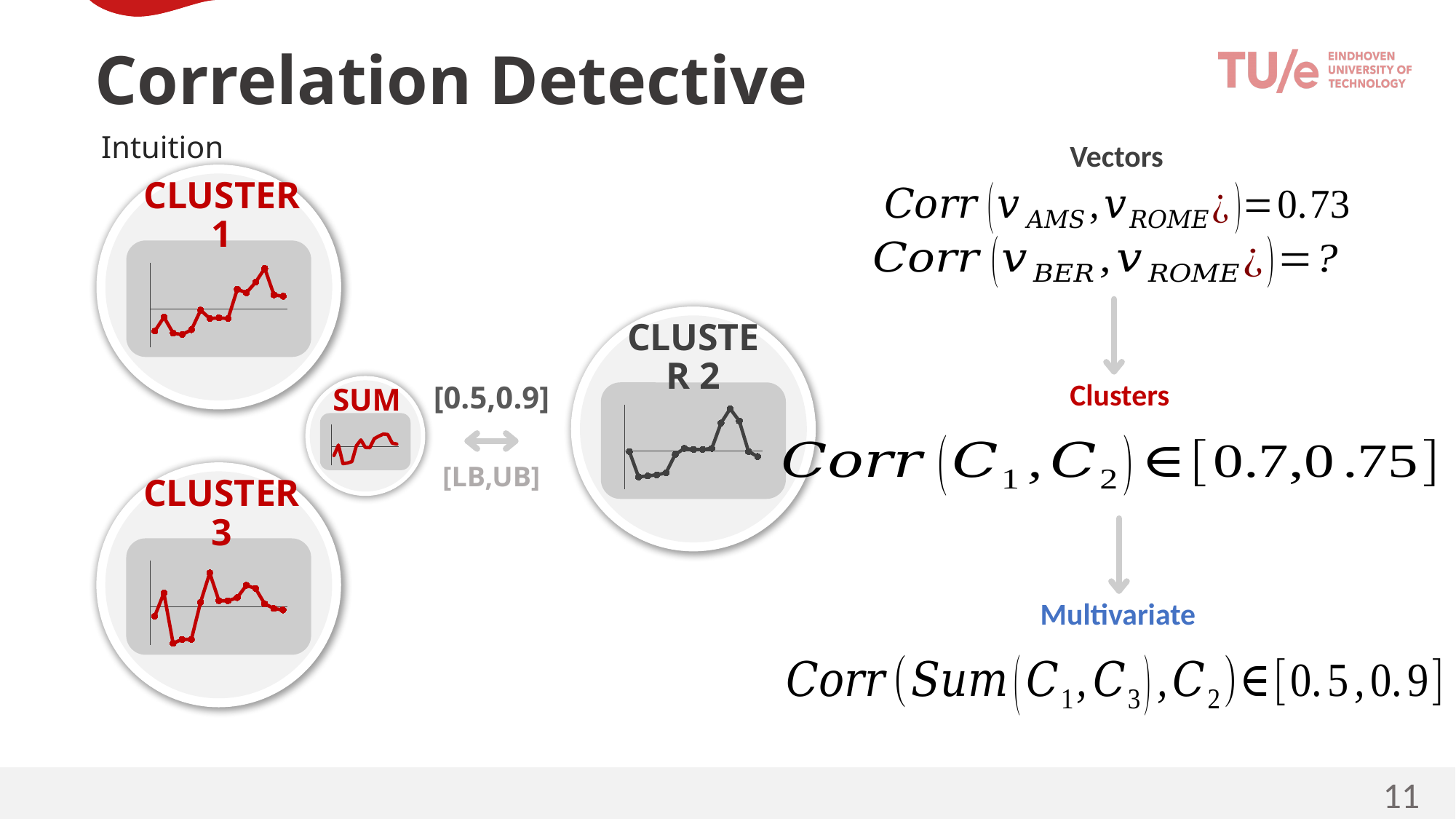
How many small line charts are shown on the slide? 4 What kind of chart is shown inside the Cluster 2 circle? line chart In the Cluster 1 chart, do the values generally rise or fall from left to right? rise What kind of chart is shown inside the Cluster 1 circle? line chart What colour is the line in the Cluster 3 chart? red What colour is the line in the Cluster 2 chart? dark grey